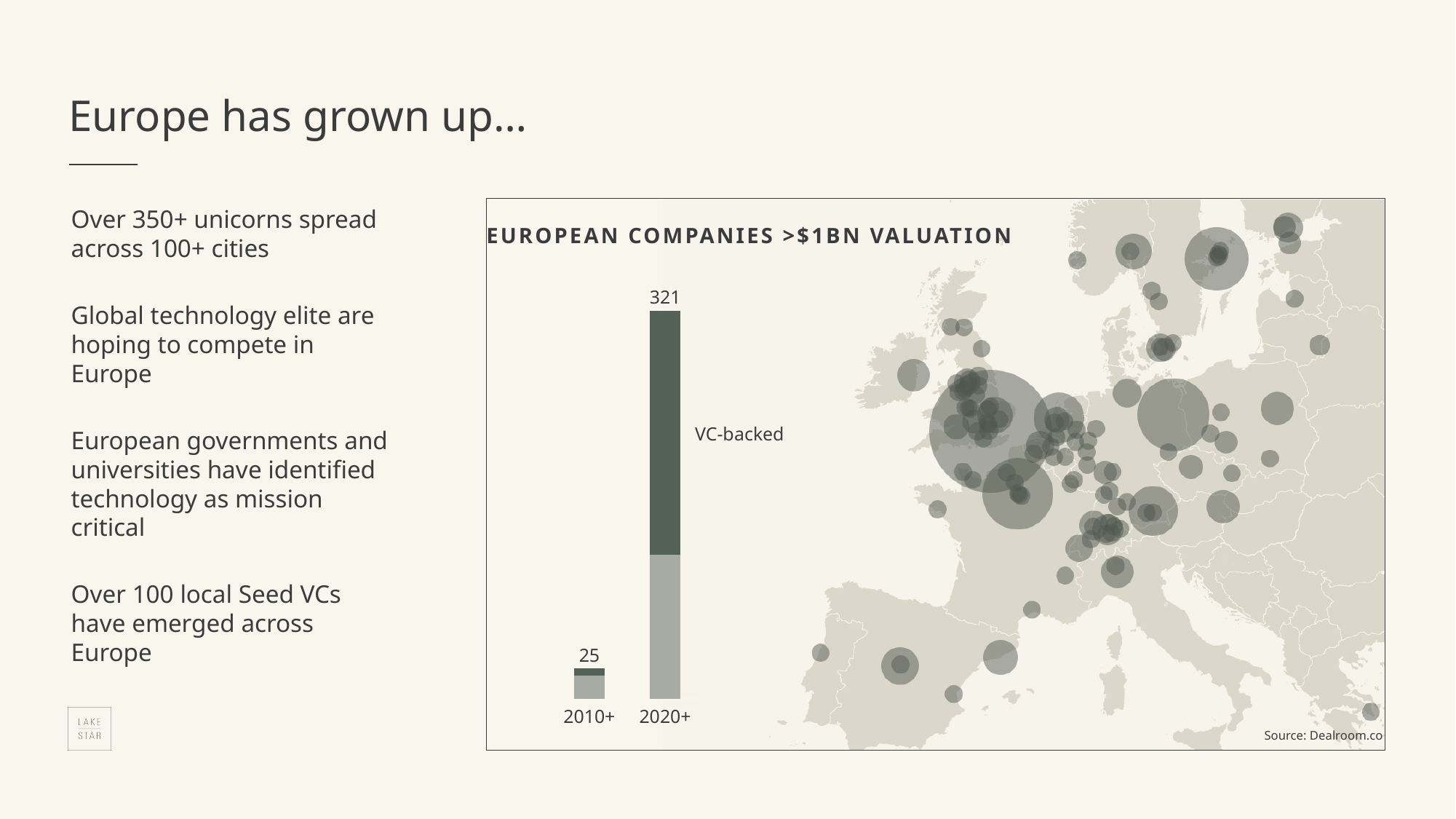
What is the total value shown for the 2010+ bar in the European Companies >$1bn Valuation chart? 25 Which category has the highest total in the European Companies >$1bn Valuation chart? 2020+ What is the total value shown for the 2020+ bar in the European Companies >$1bn Valuation chart? 321 Do the totals rise or fall from 2010+ to 2020+ in the European Companies >$1bn Valuation chart? Rise In the European Companies >$1bn Valuation chart, is the value for 2020+ larger or smaller than the value for 2010+? larger Which category has the lowest total in the European Companies >$1bn Valuation chart? 2010+ What is the difference between the 2020+ total and the 2010+ total in the European Companies >$1bn Valuation chart? 296 What kind of chart is the European Companies >$1bn Valuation chart? Stacked bar chart What is the title of the chart on the slide? EUROPEAN COMPANIES >$1BN VALUATION How many categories (bars) are shown in the European Companies >$1bn Valuation chart? 2 What label is attached to the dark upper segment of the 2020+ bar? VC-backed